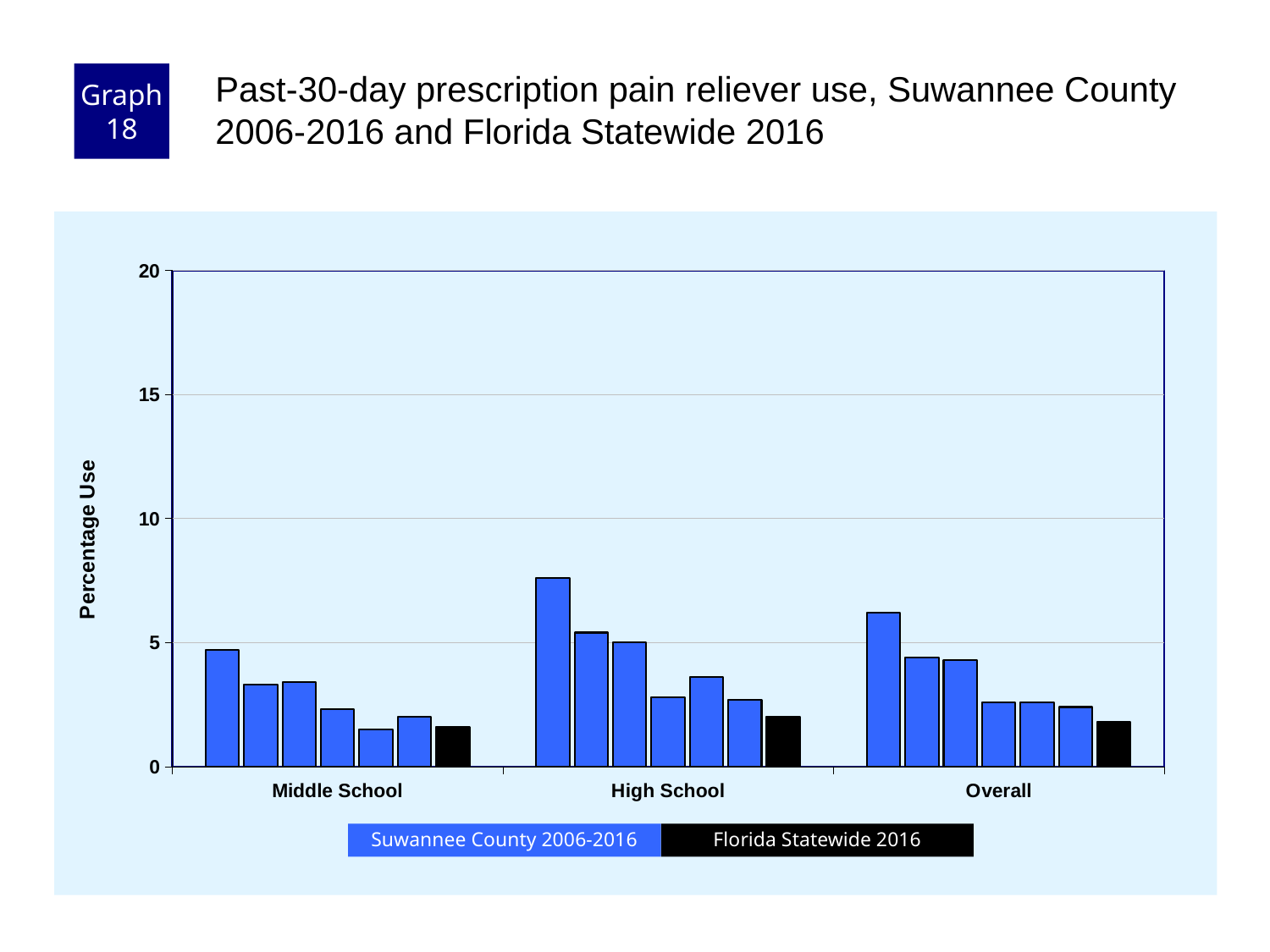
How many bars are plotted in the High School group? 7 What kind of chart is shown on the slide? bar chart Which category group contains the tallest bar on the chart? High School Within the Overall group, do the Suwannee County 2006-2016 bars generally rise or fall from left to right? fall How many category groups are shown on the x axis? 3 Is the tallest bar in the Overall group greater or less than 5? greater Which is larger: the first Suwannee County bar in the High School group or the first Suwannee County bar in the Middle School group? High School Is the tallest bar in the High School group greater or less than 5? greater What is the label on the y axis? Percentage Use How many series does the legend list? 2 Is the highest value on the chart greater or less than 10? less